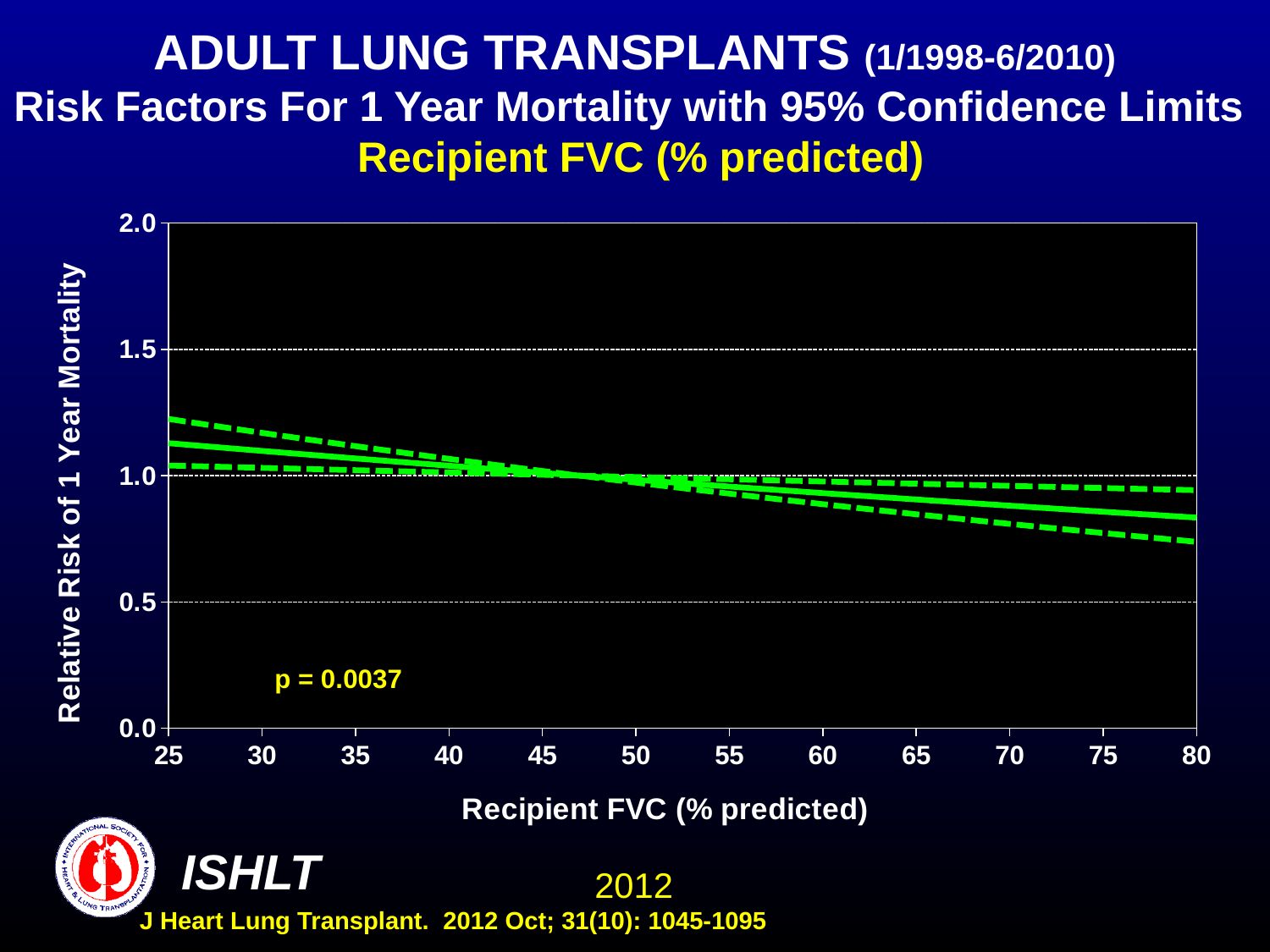
How many lines are plotted on the chart, including the confidence limits? 3 What p-value is printed on the chart? p = 0.0037 Is the relative risk on the solid line at a recipient FVC of 25% predicted greater or less than 1.0? greater How many tick labels are shown on the x axis (Recipient FVC)? 12 Is the upper 95% confidence limit at a recipient FVC of 25% predicted greater or less than 1.0? greater What is the title of the y axis? Relative Risk of 1 Year Mortality Which has the larger relative risk on the solid line: a recipient FVC of 30% predicted or 70% predicted? 30% predicted What kind of chart is shown on the slide? line chart Is the lower 95% confidence limit at a recipient FVC of 80% predicted greater or less than 0.5? greater Does the relative risk of 1 year mortality rise or fall as recipient FVC (% predicted) increases from 25 to 80? fall